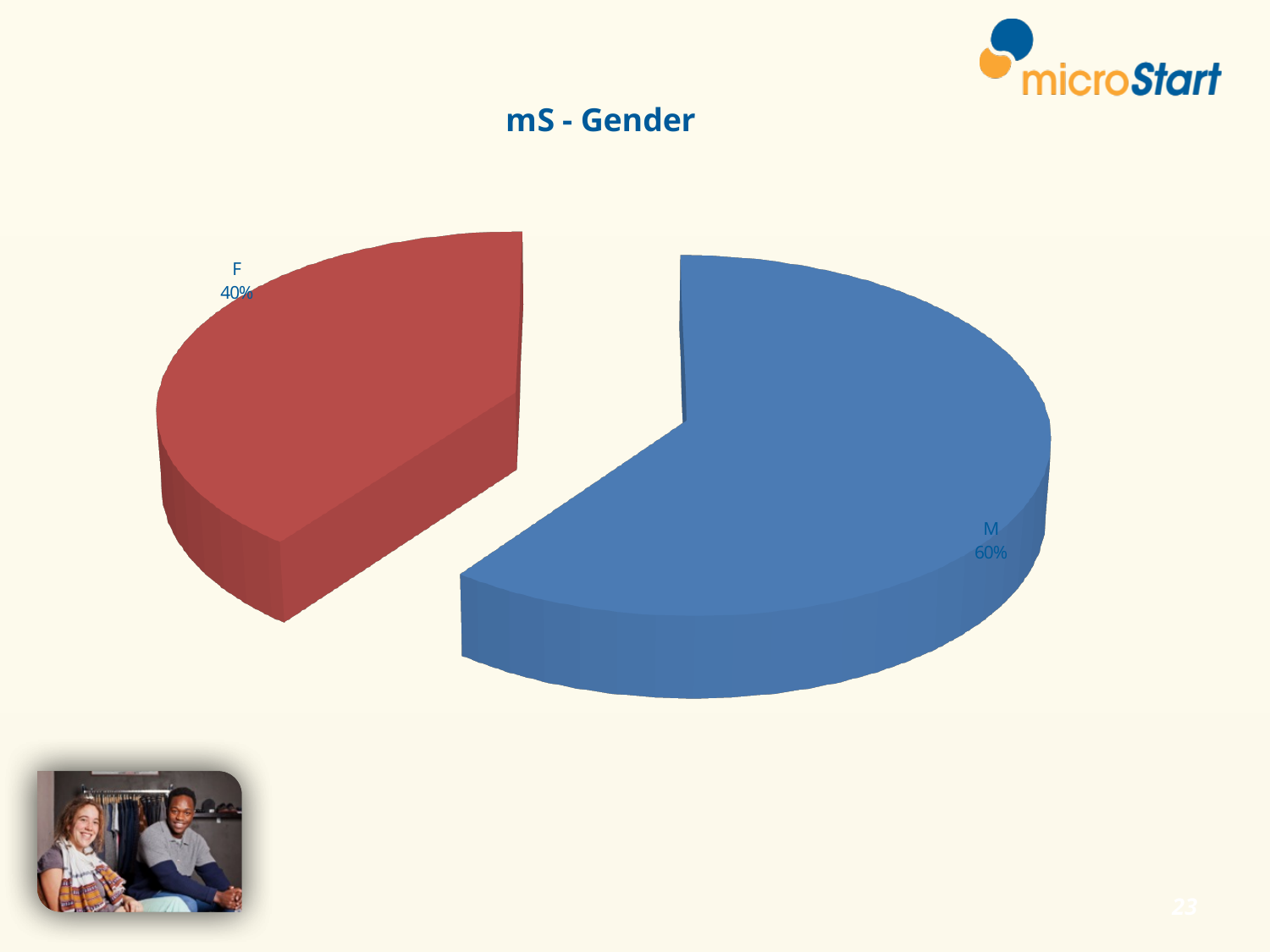
How many slices does the pie chart have? 2 Which slice is larger, M or F? M Which category has the largest slice of the pie? M What is the title of the chart? mS - Gender What colour is the M slice? blue What share of the pie does the M slice represent? 60% What share of the pie does the F slice represent? 40% Which category has the smallest slice of the pie? F What kind of chart is shown on the slide? pie chart What is the difference in percentage points between the M and F slices? 20% Is the share for F greater or less than 50%? less